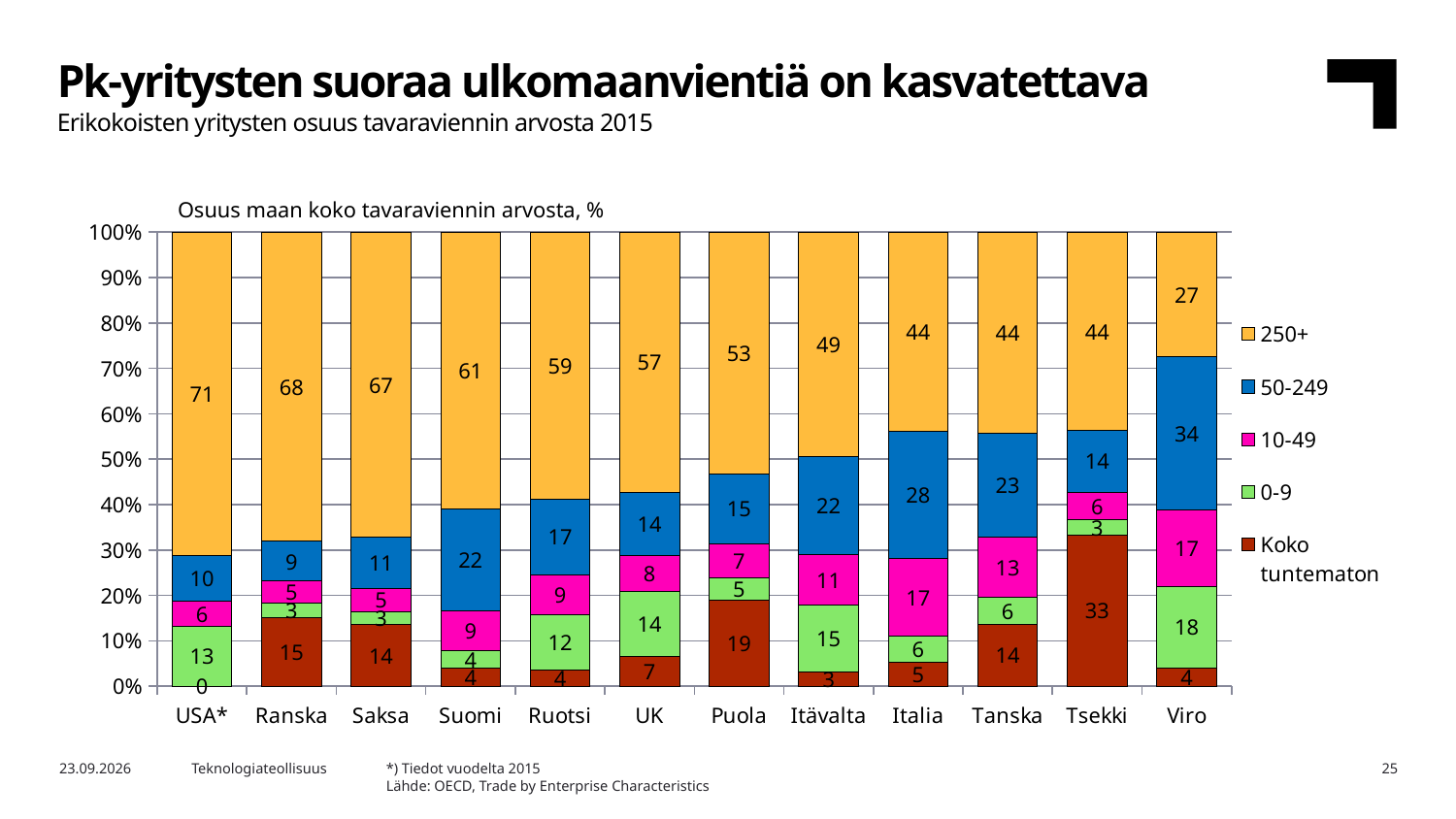
How many series does the legend list? 5 Which country has the lowest value for the 250+ series? Viro What is the value for the 0-9 series for Itävalta? 15 Which country has the highest value for the Koko tuntematon series? Tsekki What is the value for the 50-249 series for Viro? 34 What is the title printed above the chart's plot area? Osuus maan koko tavaraviennin arvosta, % Which is larger, the 50-249 value for Italia or for Tanska? Italia What is the value for the Koko tuntematon series for Tsekki? 33 What kind of chart is shown on the slide? Stacked bar chart How many countries are shown on the x axis? 12 What is the value for the 250+ series for USA*? 71 What is the difference between the 250+ values for USA* and Viro? 44